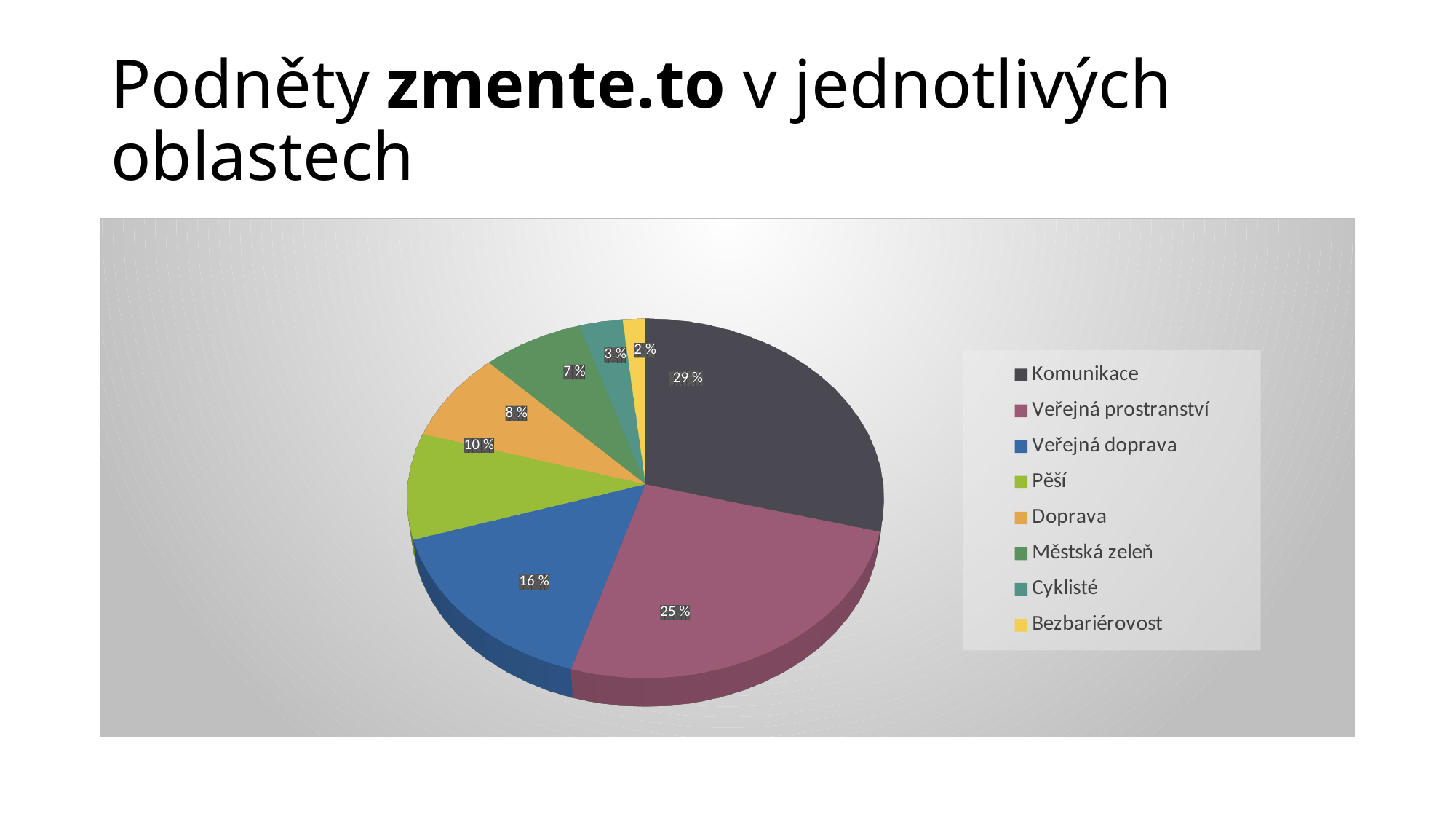
How many categories does the legend list? 8 Which category has the largest slice of the pie? Komunikace What share of the pie does Veřejná doprava have? 16 % Which category has the smallest slice of the pie? Bezbariérovost Which is larger, the slice for Městská zeleň or the slice for Cyklisté? Městská zeleň What share of the pie does Bezbariérovost have? 2 % What share of the pie does Komunikace have? 29 % What is the difference in percentage points between Komunikace and Veřejná doprava? 13 What kind of chart is shown on the slide? pie chart What share of the pie does Pěší have? 10 % What share of the pie does Doprava have? 8 % What share of the pie does Veřejná prostranství have? 25 %